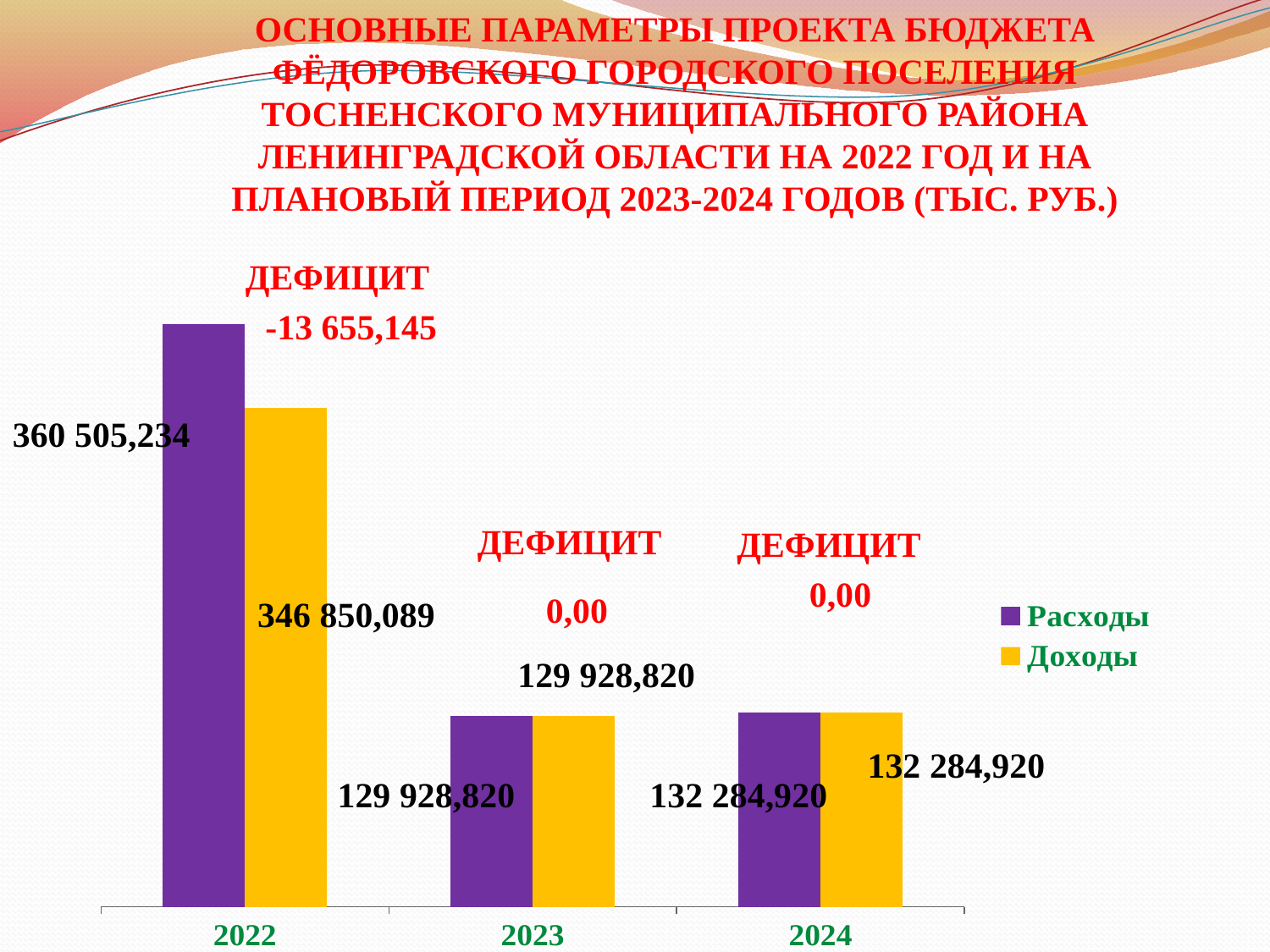
What is the value of Расходы for 2023? 129 928,820 What is the value of Доходы for 2024? 132 284,920 What is the value of Доходы for 2022? 346 850,089 Which year has the lowest value for Доходы? 2023 Which series is shown in yellow according to the legend? Доходы What is the deficit (ДЕФИЦИТ) shown for 2022? -13 655,145 Which is larger in 2022, Расходы or Доходы? Расходы What is the value of Расходы for 2022? 360 505,234 How many years (categories) are shown on the x axis? 3 Which year has the highest value for Расходы? 2022 What type of chart is shown on the slide? bar chart How many series does the legend list? 2